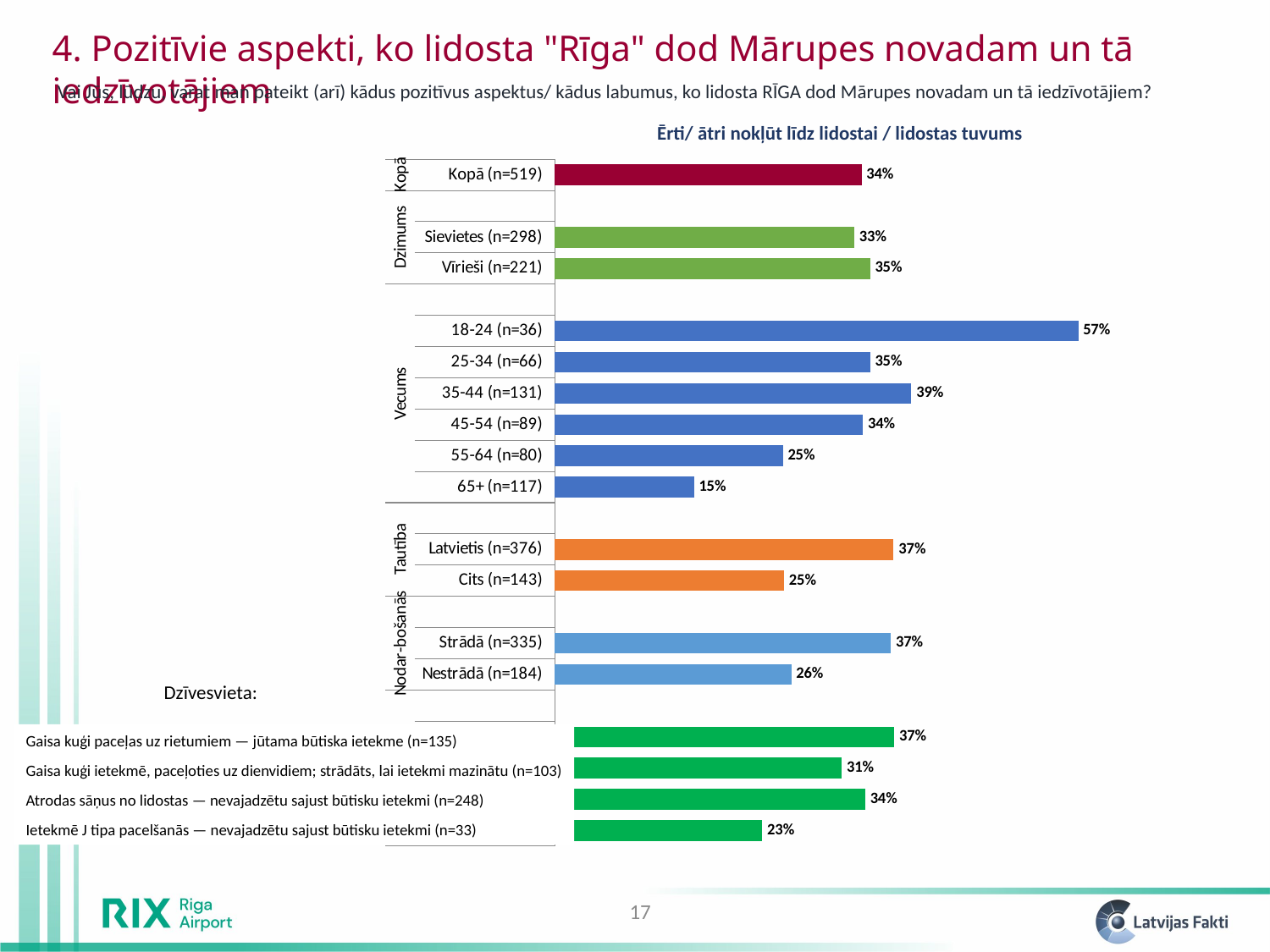
What is the value for 'Ietekmē J tipa pacelšanās — nevajadzētu sajust būtisku ietekmi (n=33)'? 23% Which age group in the Vecums section has the highest value? 18-24 (n=36) What is the value for the 18-24 (n=36) age group? 57% How many age groups are shown in the Vecums section? 6 What is the value for Nestrādā (n=184)? 26% What is the difference between the values for 18-24 (n=36) and 65+ (n=117)? 42% What type of chart is shown on the slide? Bar chart What is the title of the chart? Ērti/ ātri nokļūt līdz lidostai / lidostas tuvums What is the value for Kopā (n=519)? 34% Which age group in the Vecums section has the lowest value? 65+ (n=117) Which is larger, the value for Sievietes (n=298) or Vīrieši (n=221)? Vīrieši (n=221) What is the difference between the values for Latvietis (n=376) and Cits (n=143)? 12%